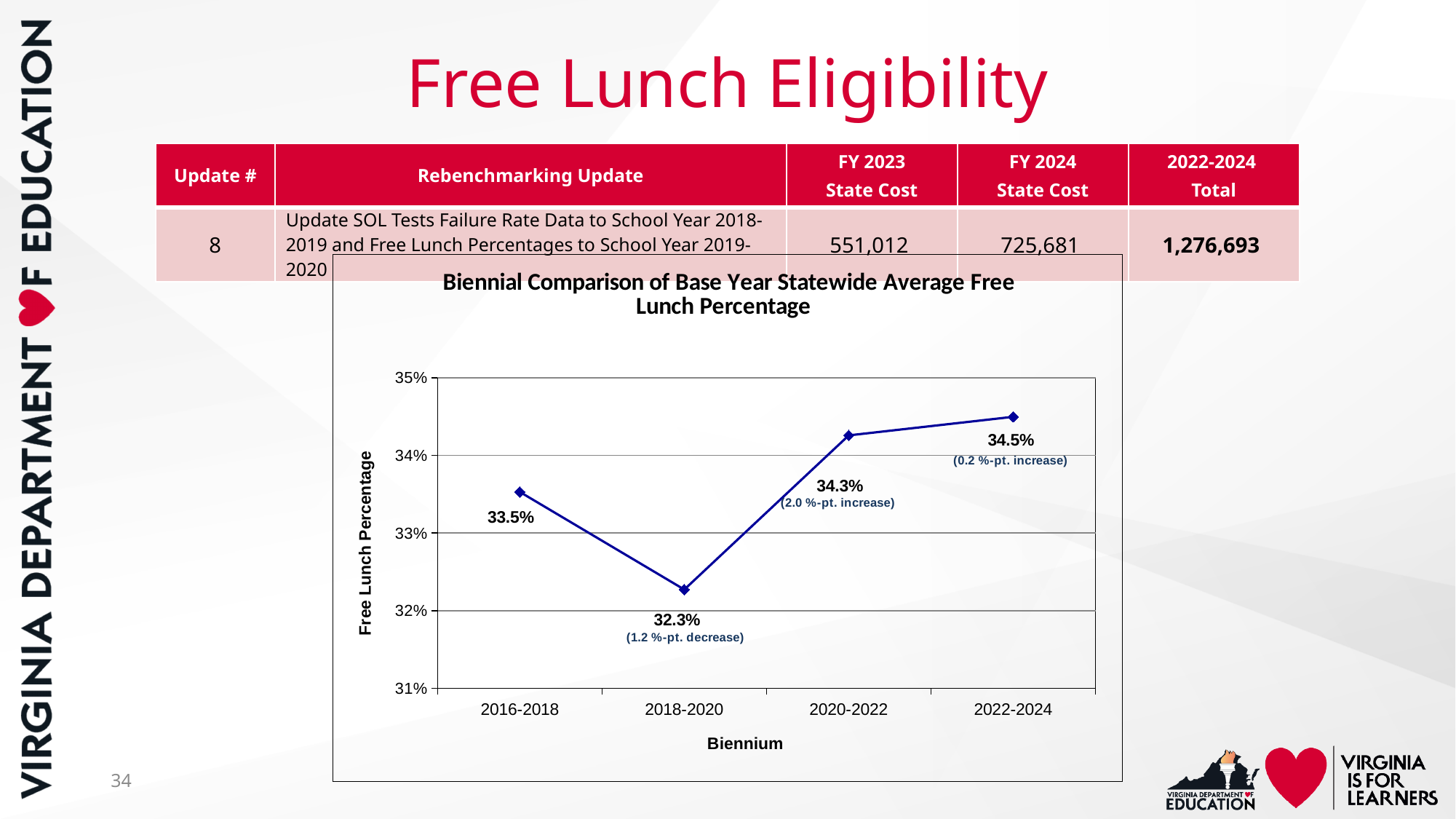
What is the title of the chart? Biennial Comparison of Base Year Statewide Average Free Lunch Percentage What is the free lunch percentage for the 2022-2024 biennium? 34.5% What is the free lunch percentage for the 2018-2020 biennium? 32.3% Which biennium has a larger free lunch percentage, 2016-2018 or 2018-2020? 2016-2018 How many bienniums are plotted on the chart? 4 What is the free lunch percentage for the 2016-2018 biennium? 33.5% Which biennium has the highest free lunch percentage? 2022-2024 What is the free lunch percentage for the 2020-2022 biennium? 34.3% Is the free lunch percentage for 2018-2020 greater or less than 33%? less Which biennium has the lowest free lunch percentage? 2018-2020 What kind of chart is shown on the slide? Line chart What is the difference in free lunch percentage between the 2020-2022 and 2018-2020 bienniums? 2.0 %-pt.